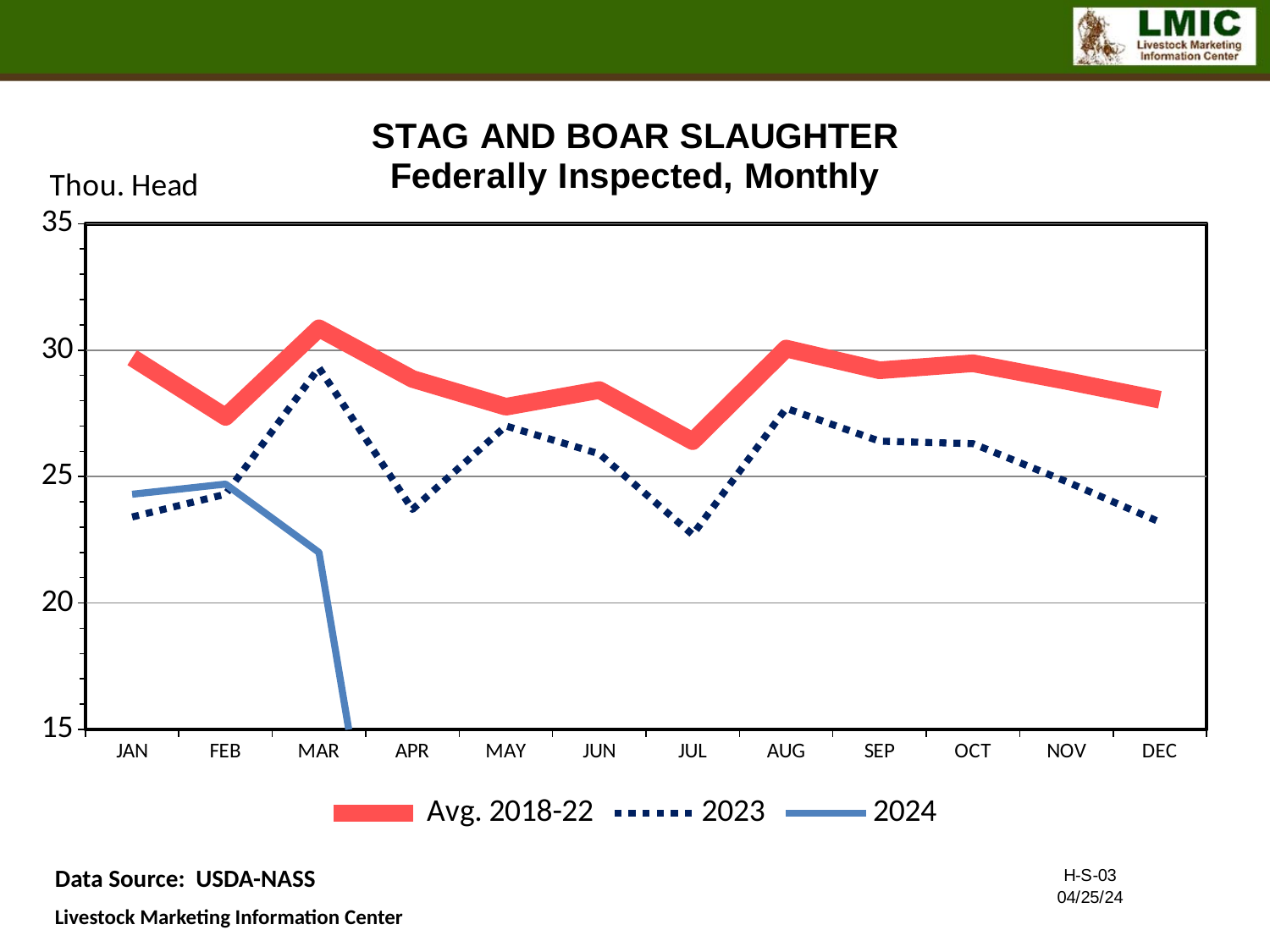
How many months are shown along the x axis? 12 What kind of chart is shown on the slide? line chart Is the Avg. 2018-22 value for MAR greater or less than 30? greater Which is larger in APR, the Avg. 2018-22 value or the 2023 value? Avg. 2018-22 Does the 2024 series rise or fall from JAN to MAR? fall What unit label is shown above the y axis? Thou. Head In which month is the Avg. 2018-22 series at its highest? MAR Is the 2023 value for APR greater or less than 25? less How many series does the legend list? 3 In which month is the Avg. 2018-22 series at its lowest? JUL In which month is the 2023 series at its highest? MAR Is the 2024 value for MAR greater or less than 25? less